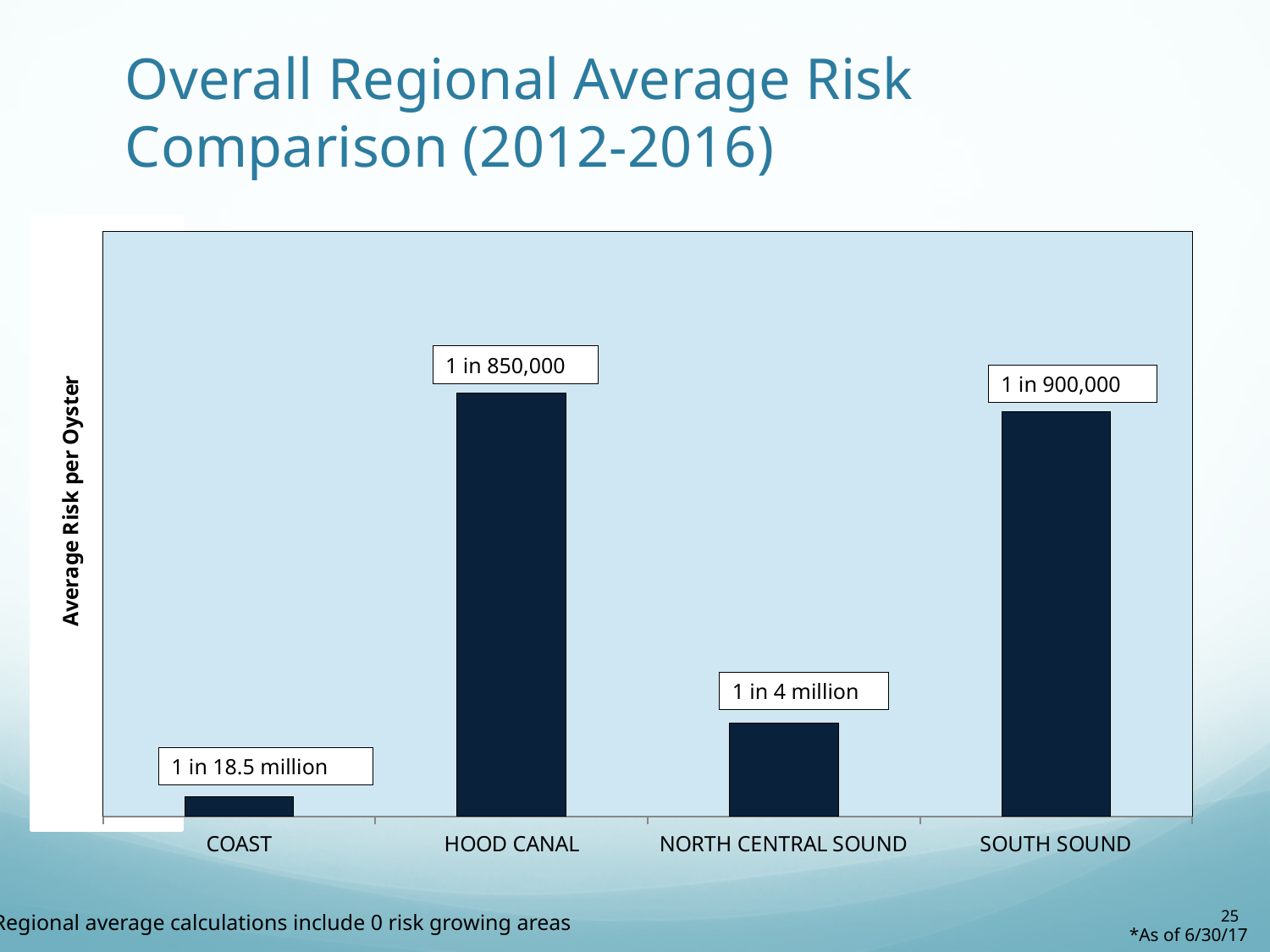
What kind of chart is shown on the slide? Bar chart What is the average risk per oyster shown for HOOD CANAL? 1 in 850,000 Which region has the tallest bar in the chart? HOOD CANAL What is the average risk per oyster shown for NORTH CENTRAL SOUND? 1 in 4 million What is the average risk per oyster shown for SOUTH SOUND? 1 in 900,000 How many regions are shown in the chart? 4 What is the title of the slide containing the chart? Overall Regional Average Risk Comparison (2012-2016) Which region has a taller bar, COAST or NORTH CENTRAL SOUND? NORTH CENTRAL SOUND What is the average risk per oyster shown for COAST? 1 in 18.5 million Which region has a taller bar, HOOD CANAL or NORTH CENTRAL SOUND? HOOD CANAL Which region has the shortest bar in the chart? COAST What is the label on the vertical axis of the chart? Average Risk per Oyster